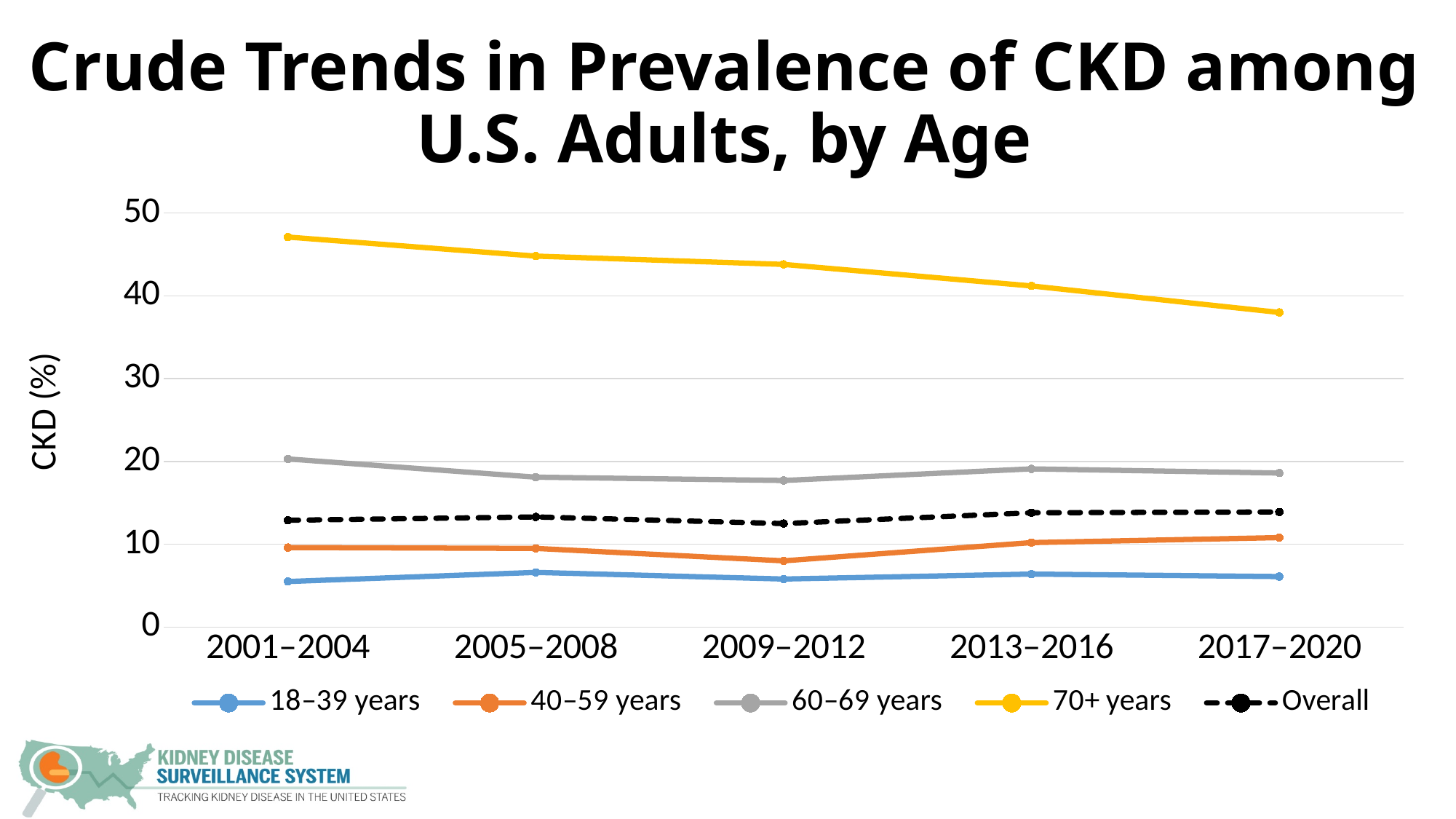
How many time periods are shown along the x axis? 5 How many series does the legend list? 5 Which is larger in 2013–2016, the value for 60–69 years or the value for 40–59 years? 60–69 years Is the value for 18–39 years in 2001–2004 greater or less than 10? less Is the value for 70+ years in 2017–2020 greater or less than 40? less Is the value for 70+ years in 2001–2004 greater or less than 40? greater Which series is drawn with a dashed line? Overall What kind of chart is shown on the slide? line chart Does the CKD prevalence for the 70+ years group rise or fall from 2001–2004 to 2017–2020? fall Which age group has the lowest CKD prevalence in 2001–2004? 18–39 years Which age group has the highest CKD prevalence in 2017–2020? 70+ years